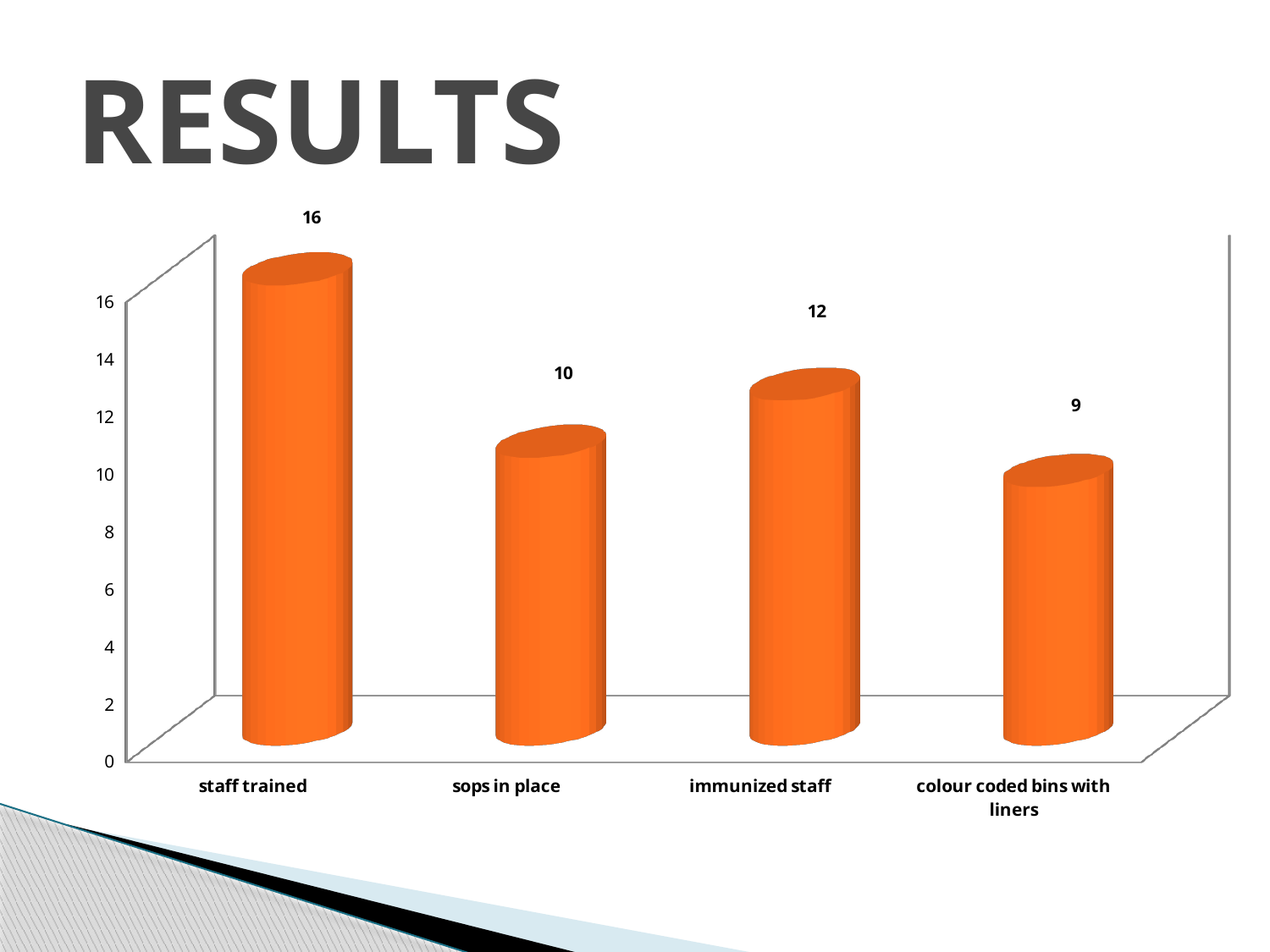
What is the title of the slide containing the chart? RESULTS What kind of chart is shown on the slide? bar chart Which category has the lowest value? colour coded bins with liners What is the value for staff trained? 16 What is the value for colour coded bins with liners? 9 What is the value for sops in place? 10 What is the difference between the values for immunized staff and colour coded bins with liners? 3 Which category has the highest value? staff trained How many categories are shown in the chart? 4 What is the difference between the values for staff trained and sops in place? 6 What is the value for immunized staff? 12 Which is larger, the value for immunized staff or the value for sops in place? immunized staff